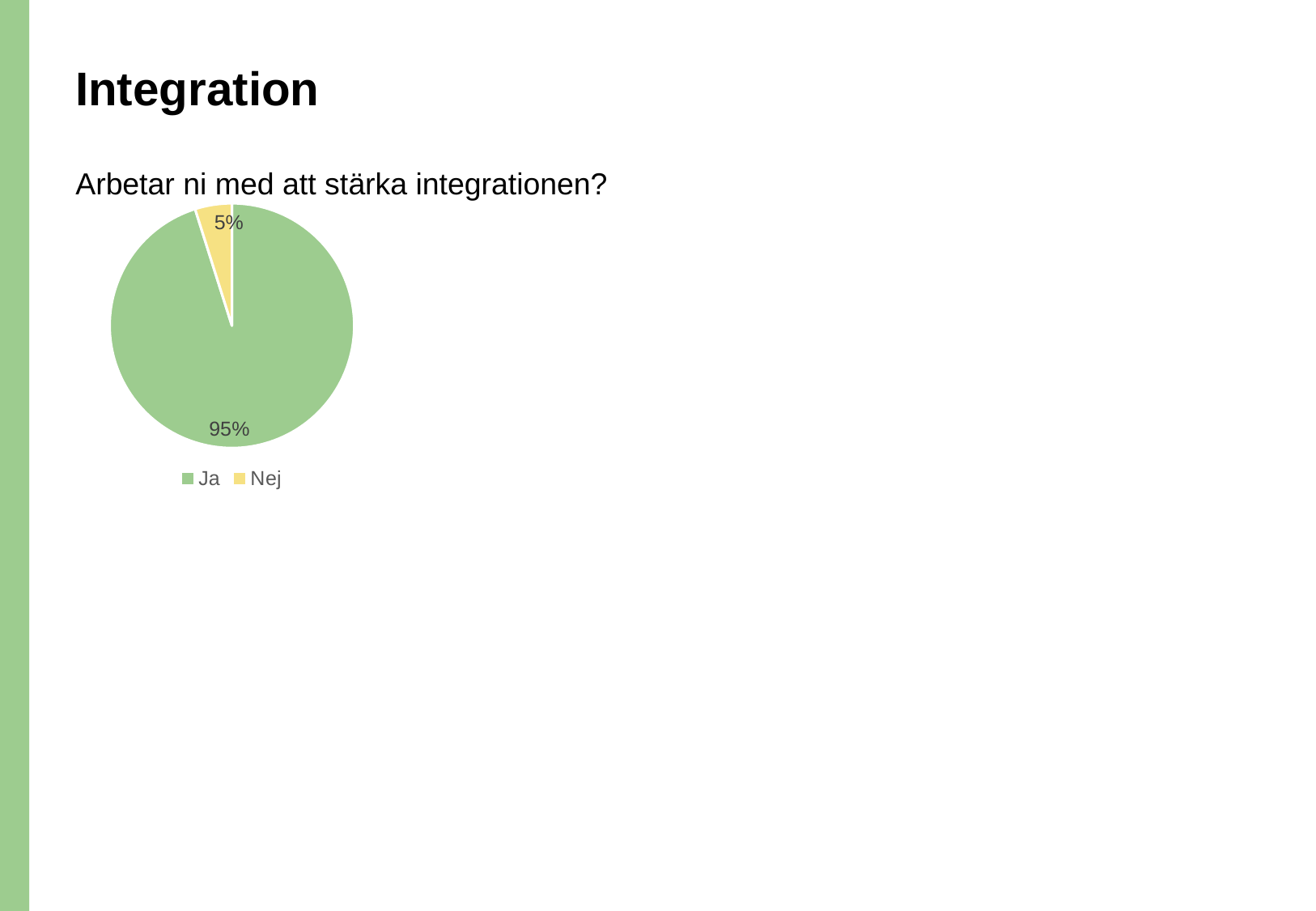
What share of the pie is labelled "Nej"? 5% What colour is the "Nej" slice of the pie? Yellow How many entries does the legend list? 2 What kind of chart is shown on the slide? Pie chart How many categories does the pie chart have? 2 Which category has the smallest slice of the pie? Nej What question does the chart answer, according to the text above it? Arbetar ni med att stärka integrationen? Which category has the largest slice of the pie? Ja What share of the pie is labelled "Ja"? 95% What is the difference in percentage points between the "Ja" and "Nej" slices? 90 Which slice is larger, "Ja" or "Nej"? Ja